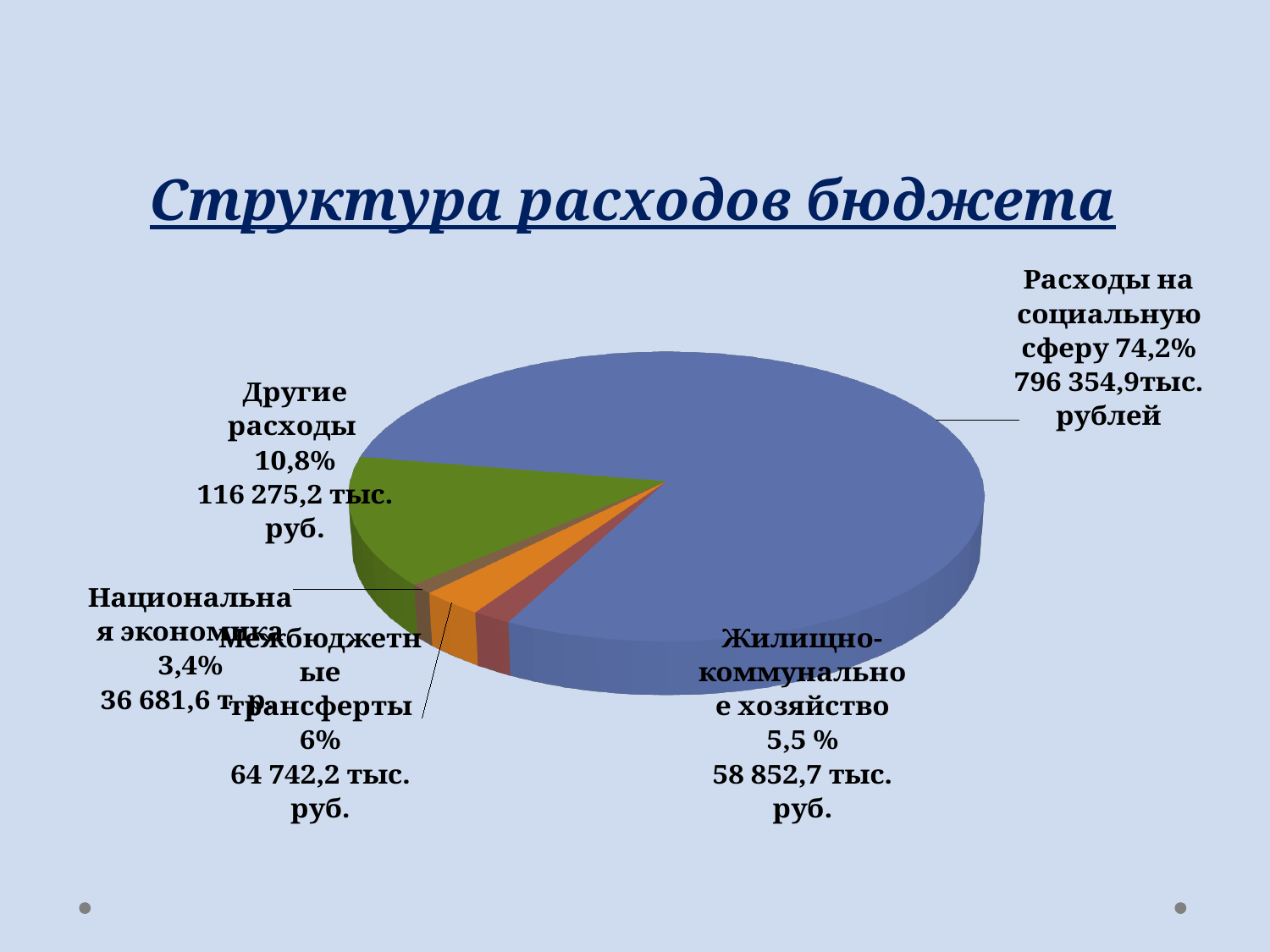
What is the title of the chart? Структура расходов бюджета Which category has the largest share of the pie? Расходы на социальную сферу Which category has the smallest share of the pie? Национальная экономика What share of the pie is Расходы на социальную сферу? 74,2% Which is larger: the share for Межбюджетные трансферты or for Жилищно-коммунальное хозяйство? Межбюджетные трансферты What share of the pie is Другие расходы? 10,8% What share of the pie is Жилищно-коммунальное хозяйство? 5,5 % What kind of chart is shown on the slide? Pie chart What is the difference in percentage points between Другие расходы and Национальная экономика? 7,4 What is the value in thousand rubles for Межбюджетные трансферты? 64 742,2 тыс. руб. What is the value in thousand rubles for Расходы на социальную сферу? 796 354,9 тыс. рублей How many slices does the pie chart have? 5